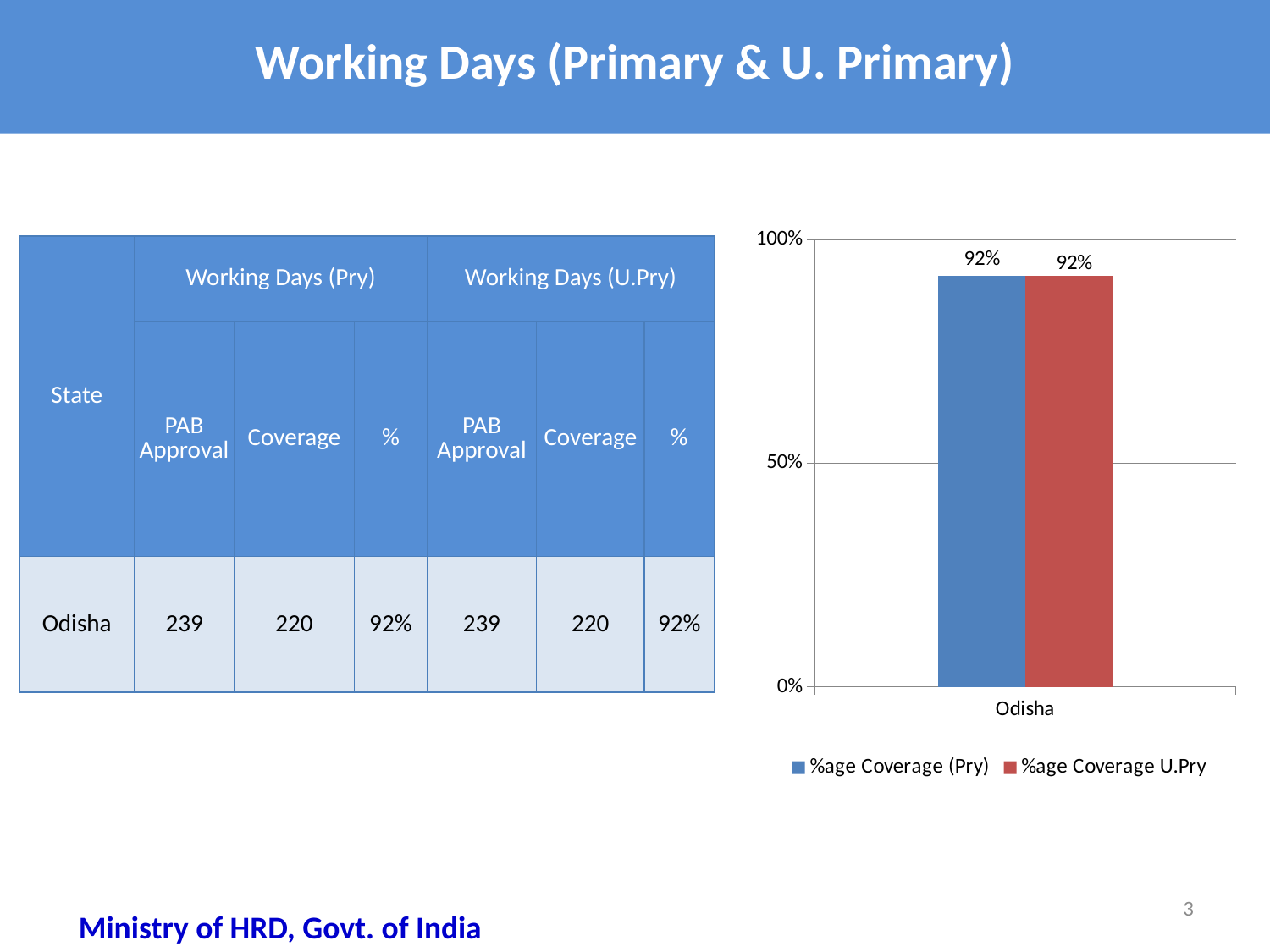
What is the difference between the %age Coverage (Pry) and %age Coverage U.Pry values for Odisha? 0% What is the value of %age Coverage (Pry) for Odisha in the chart? 92% Is the %age Coverage (Pry) value for Odisha greater or less than 50%? greater How many series does the chart legend list? 2 How many categories are shown on the x axis of the chart? 1 What kind of chart is shown on the slide? bar chart What is the value of %age Coverage U.Pry for Odisha in the chart? 92% What colour is the %age Coverage U.Pry bar in the chart? red Which state is shown on the x axis of the chart? Odisha Is the %age Coverage U.Pry value for Odisha greater or less than 100%? less